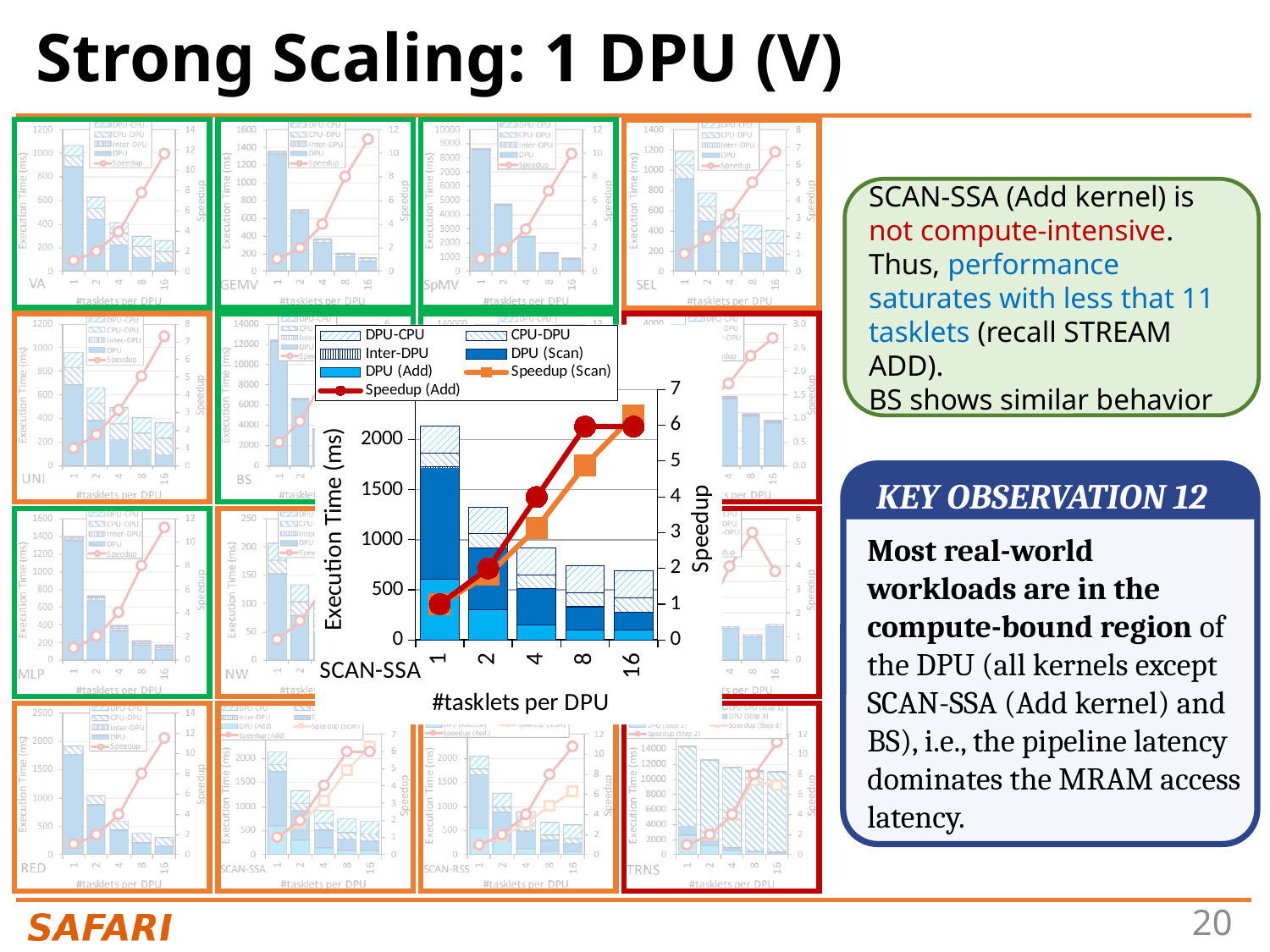
What is the x-axis label of the enlarged SCAN-SSA chart? #tasklets per DPU On the enlarged SCAN-SSA chart, at 8 tasklets per DPU, which is larger: Speedup (Add) or Speedup (Scan)? Speedup (Add) On the enlarged SCAN-SSA chart, is the total execution time for 1 tasklet per DPU greater or less than 2000 ms? greater On the enlarged SCAN-SSA chart, which #tasklets per DPU value has the highest total execution time? 1 On the enlarged SCAN-SSA chart, how many #tasklets per DPU categories are shown on the x axis? 5 On the enlarged SCAN-SSA chart, is the Speedup (Add) value at 16 tasklets per DPU greater or less than 5? greater On the enlarged SCAN-SSA chart, how many series does the legend list? 7 What kind of chart is the enlarged SCAN-SSA chart? Bar chart (stacked bars with speedup lines) On the enlarged SCAN-SSA chart, is the total execution time for 16 tasklets per DPU greater or less than 1000 ms? less On the enlarged SCAN-SSA chart, how does the total execution time change as #tasklets per DPU increases from 1 to 16? It falls On the enlarged SCAN-SSA chart, how does Speedup (Scan) change as #tasklets per DPU increases from 1 to 16? It rises